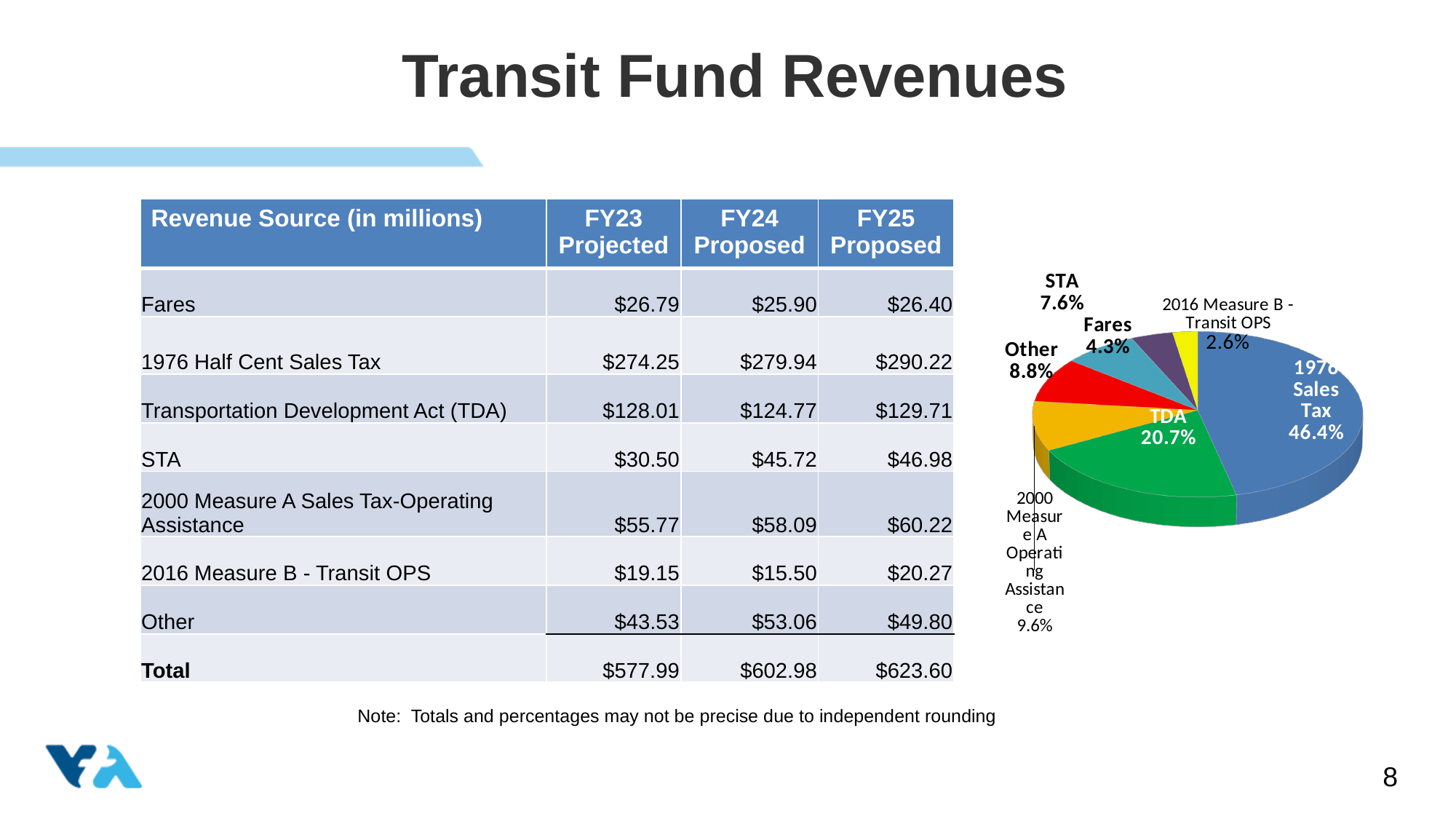
In the pie chart, how many percentage points larger is the 1976 Sales Tax share than the TDA share? 25.7 Which slice of the pie chart is the smallest? 2016 Measure B - Transit OPS In the pie chart, what share does 2016 Measure B - Transit OPS have? 2.6% In the pie chart, what share does STA have? 7.6% What kind of chart is shown on the right of the slide? pie chart In the pie chart, what share does TDA have? 20.7% Which slice of the pie chart is the largest? 1976 Sales Tax In the pie chart, which is larger: the share for STA or the share for Fares? STA How many slices does the pie chart have? 7